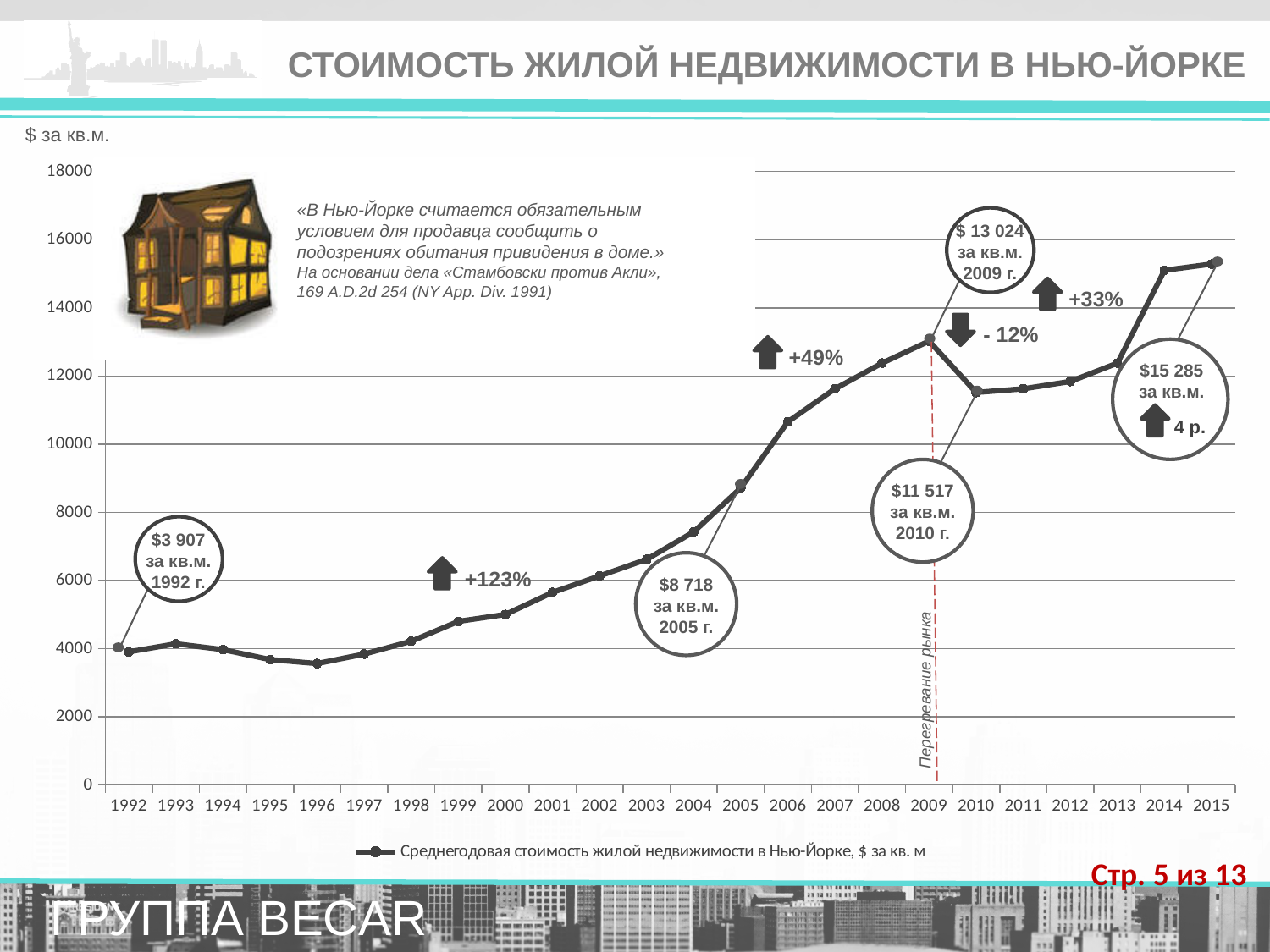
What value does the callout give for 2005? $8 718 за кв.м. What was the average annual cost of residential real estate in New York in 1992, according to the callout? $3 907 за кв.м. Is the value for 2006 greater or less than 10000? greater What kind of chart is shown on the slide? line chart What value does the callout give for 2015? $15 285 за кв.м. What percentage change is labelled between 2005 and 2009? +49% Which year has the larger value, 2009 or 2010? 2009 What value does the callout give for 2009? $13 024 за кв.м. How many years are plotted on the x axis? 24 By how much did the value fall from 2009 to 2010, using the callout values? $1 507 What value does the callout give for 2010? $11 517 за кв.м. Is the value for 1996 greater or less than 4000? less